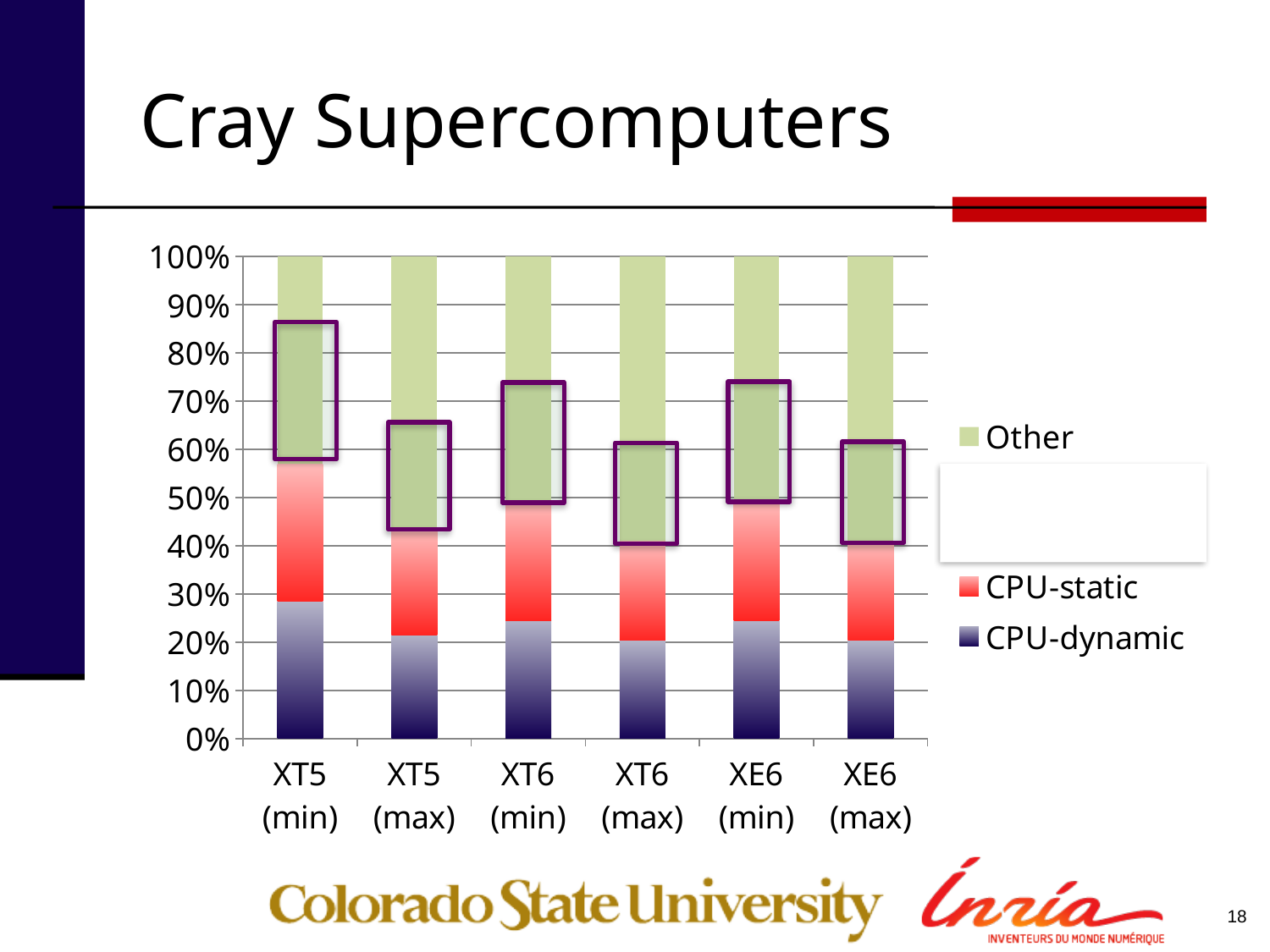
Is the CPU-dynamic value for XT5 (max) greater or less than 30%? less Is the combined CPU-dynamic and CPU-static portion for XT5 (min) greater or less than 50%? greater What is the title of the slide containing the chart? Cray Supercomputers What type of chart is shown on the slide? Stacked bar chart Is the CPU-dynamic value for XT6 (max) greater or less than 30%? less Which has the larger CPU-dynamic share, XT5 (min) or XT6 (max)? XT5 (min) What does each stacked bar total on the y axis? 100% How many categories are shown along the x axis? 6 Which category has the largest CPU-dynamic share? XT5 (min) Which series forms the bottom segment of each stacked bar? CPU-dynamic